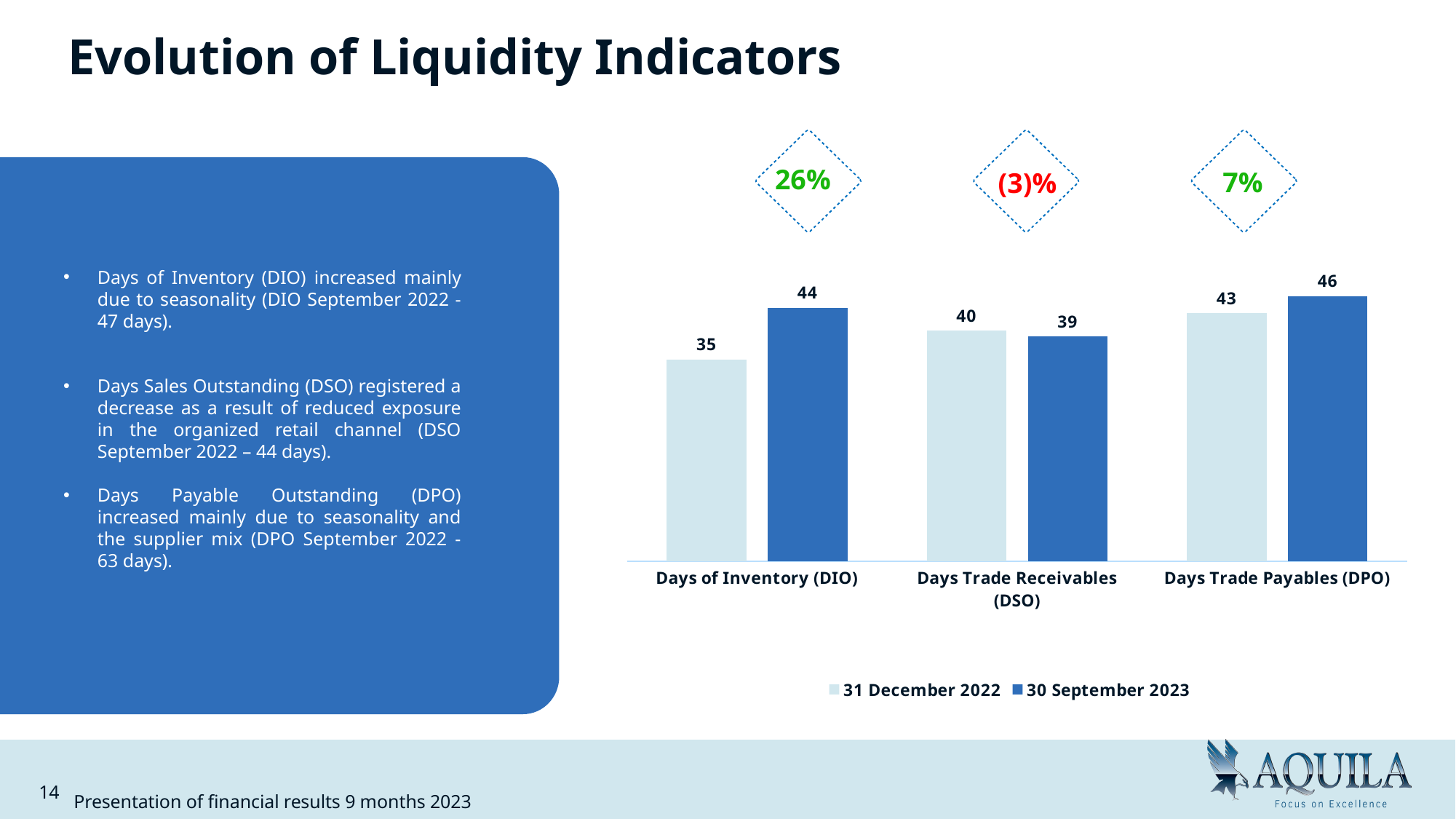
How many series does the chart legend list? 2 What is the value for Days Trade Payables (DPO) at 31 December 2022? 43 What percentage change is shown above the Days Trade Payables (DPO) bars? 7% How many categories are shown on the x axis of the chart? 3 Which is larger for Days Trade Receivables (DSO): the 31 December 2022 value or the 30 September 2023 value? 31 December 2022 What is the difference between the 30 September 2023 and 31 December 2022 values for Days of Inventory (DIO)? 9 What is the value for Days of Inventory (DIO) at 31 December 2022? 35 What kind of chart is shown on the slide? Bar chart Which category has the lowest value for 31 December 2022? Days of Inventory (DIO) What is the value for Days of Inventory (DIO) at 30 September 2023? 44 Which category has the highest value for 30 September 2023? Days Trade Payables (DPO) What is the value for Days Trade Receivables (DSO) at 30 September 2023? 39